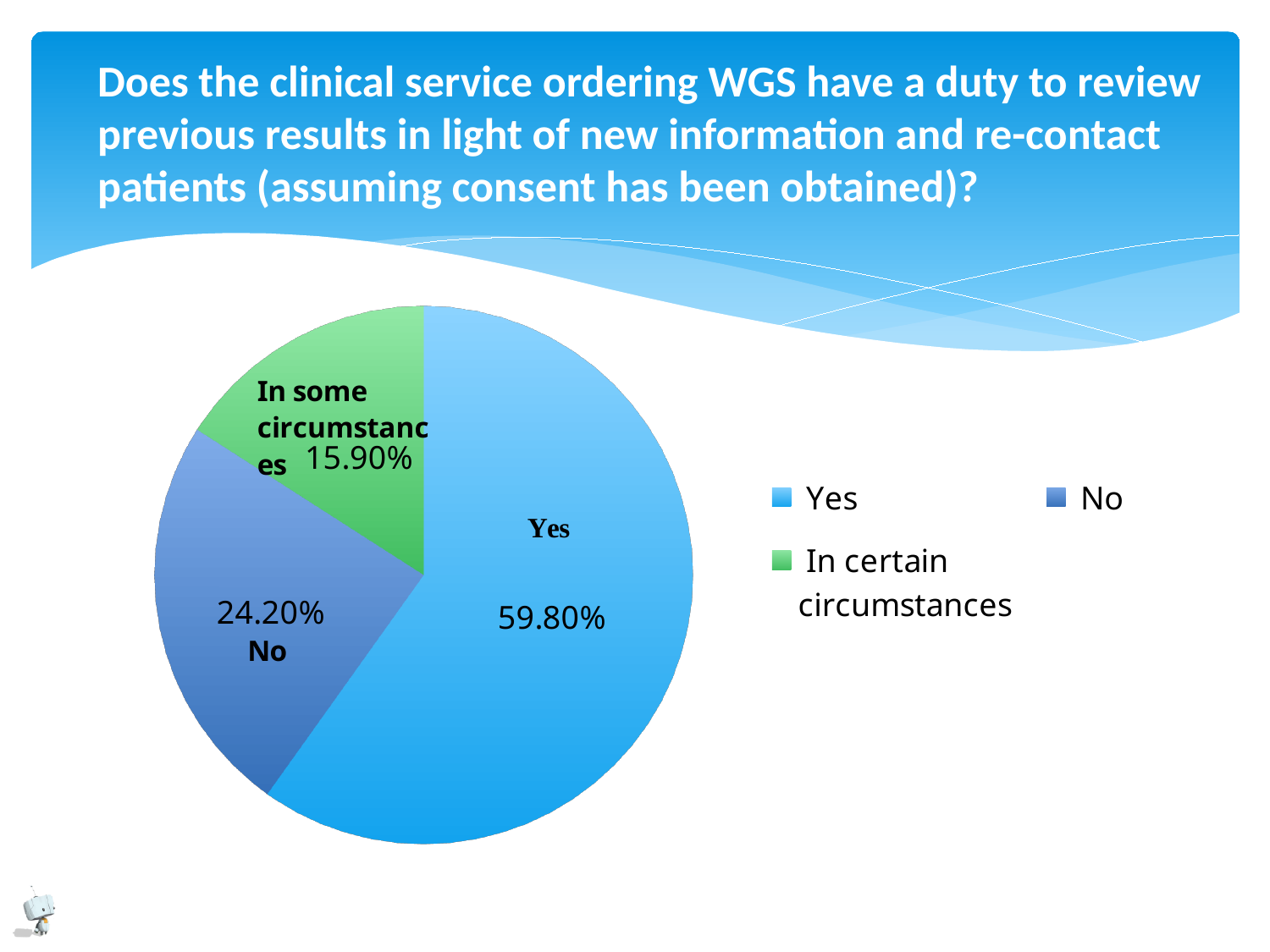
How many entries does the legend list? 3 What percentage of responses were "No"? 24.20% What colour is the "Yes" slice of the pie? Light blue What percentage of responses were "In certain circumstances"? 15.90% What percentage of responses were "Yes"? 59.80% What is the difference in percentage points between the "Yes" and "No" shares? 35.60 Which response has the largest share of the pie? Yes What kind of chart is shown on the slide? Pie chart What is the difference in percentage points between the "No" and "In certain circumstances" shares? 8.30 Which response has the smallest share of the pie? In certain circumstances How many slices does the pie chart have? 3 Which is larger, the share for "No" or the share for "In certain circumstances"? No